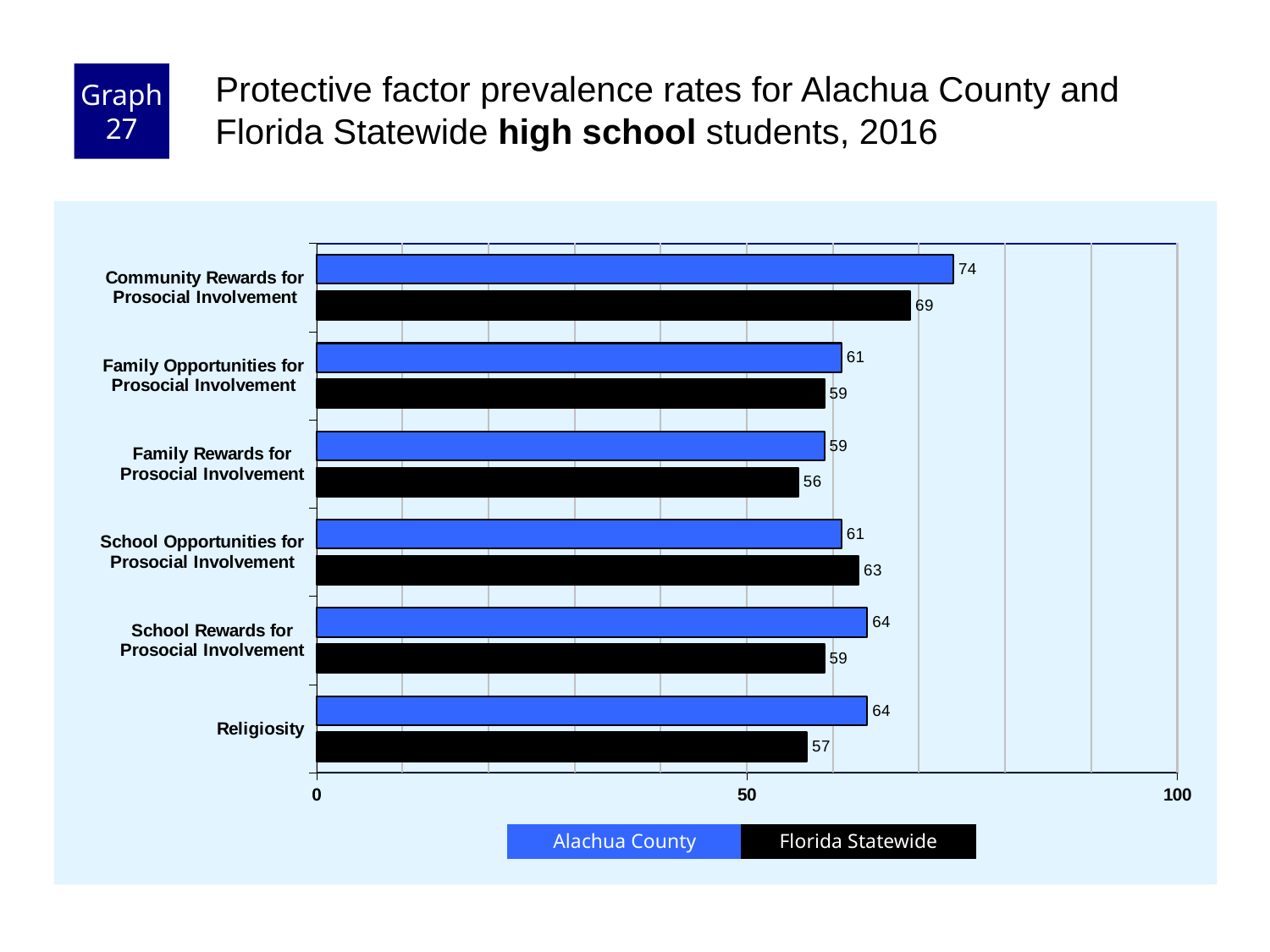
Which category has the highest Alachua County value? Community Rewards for Prosocial Involvement What is the difference between the Alachua County and Florida Statewide values for Religiosity? 7 How many protective factor categories are shown on the chart? 6 What kind of chart is shown on the slide? bar chart For School Opportunities for Prosocial Involvement, which is larger: Alachua County or Florida Statewide? Florida Statewide What is the Florida Statewide value for School Opportunities for Prosocial Involvement? 63 Which category has the lowest Florida Statewide value? Family Rewards for Prosocial Involvement How many series does the legend list? 2 What is the Alachua County value for Community Rewards for Prosocial Involvement? 74 Is the Alachua County value for Community Rewards for Prosocial Involvement greater or less than 50? greater What is the Florida Statewide value for Religiosity? 57 What is the difference between the Alachua County and Florida Statewide values for Community Rewards for Prosocial Involvement? 5